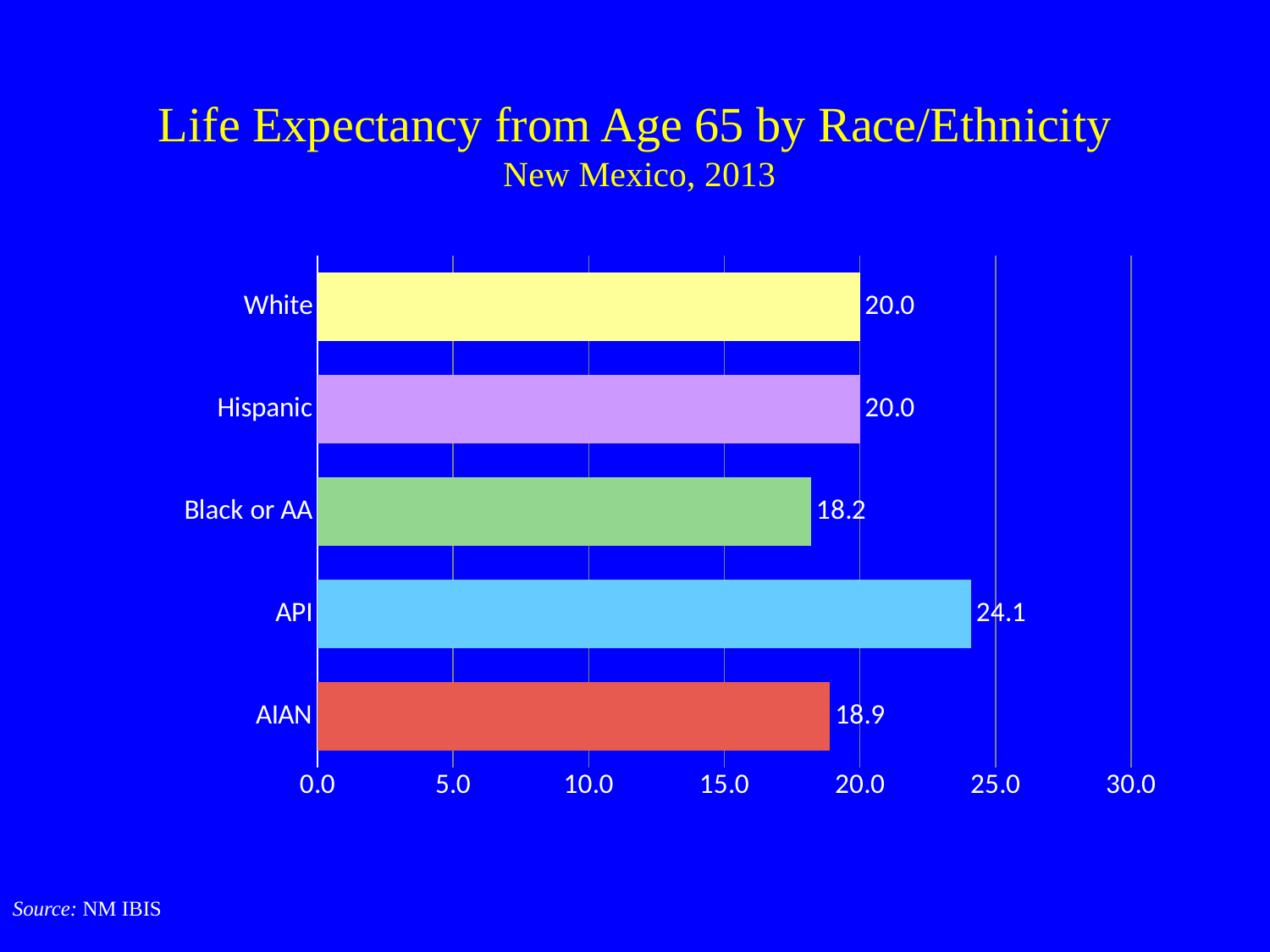
How many race/ethnicity categories are shown in the chart? 5 What is the difference between the life expectancy from age 65 for API and for Black or AA? 5.9 What is the difference between the life expectancy from age 65 for White and for AIAN? 1.1 What is the life expectancy from age 65 for AIAN? 18.9 What is the source cited for the chart? NM IBIS What is the life expectancy from age 65 for API? 24.1 What is the life expectancy from age 65 for Black or AA? 18.2 What kind of chart is shown on the slide? Bar chart What is the life expectancy from age 65 for Hispanic? 20.0 Which race/ethnicity group has the highest life expectancy from age 65? API Which has a higher life expectancy from age 65, AIAN or Black or AA? AIAN Which race/ethnicity group has the lowest life expectancy from age 65? Black or AA